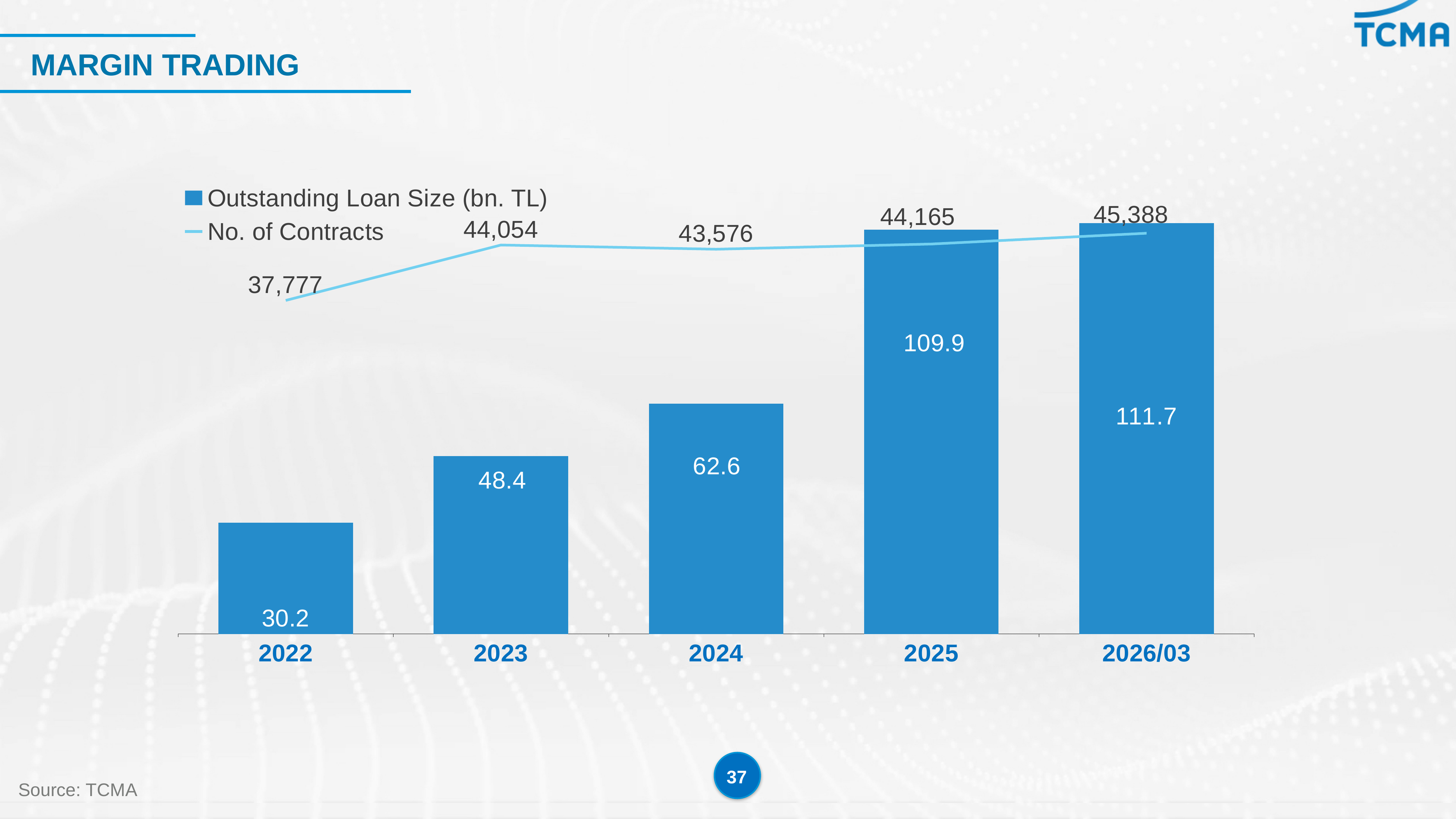
Which is larger, the No. of Contracts in 2023 or in 2024? 2023 Which year has the lowest Outstanding Loan Size (bn. TL)? 2022 What is the title of the slide? MARGIN TRADING What is the Outstanding Loan Size (bn. TL) for 2026/03? 111.7 What is the difference in Outstanding Loan Size (bn. TL) between 2025 and 2024? 47.3 Does the Outstanding Loan Size (bn. TL) rise or fall from 2022 to 2026/03? rise Which period has the highest No. of Contracts? 2026/03 How many series does the legend list? 2 How many periods are shown on the x axis? 5 What is the No. of Contracts for 2023? 44,054 What is the Outstanding Loan Size (bn. TL) for 2024? 62.6 What is the difference in No. of Contracts between 2023 and 2022? 6,277